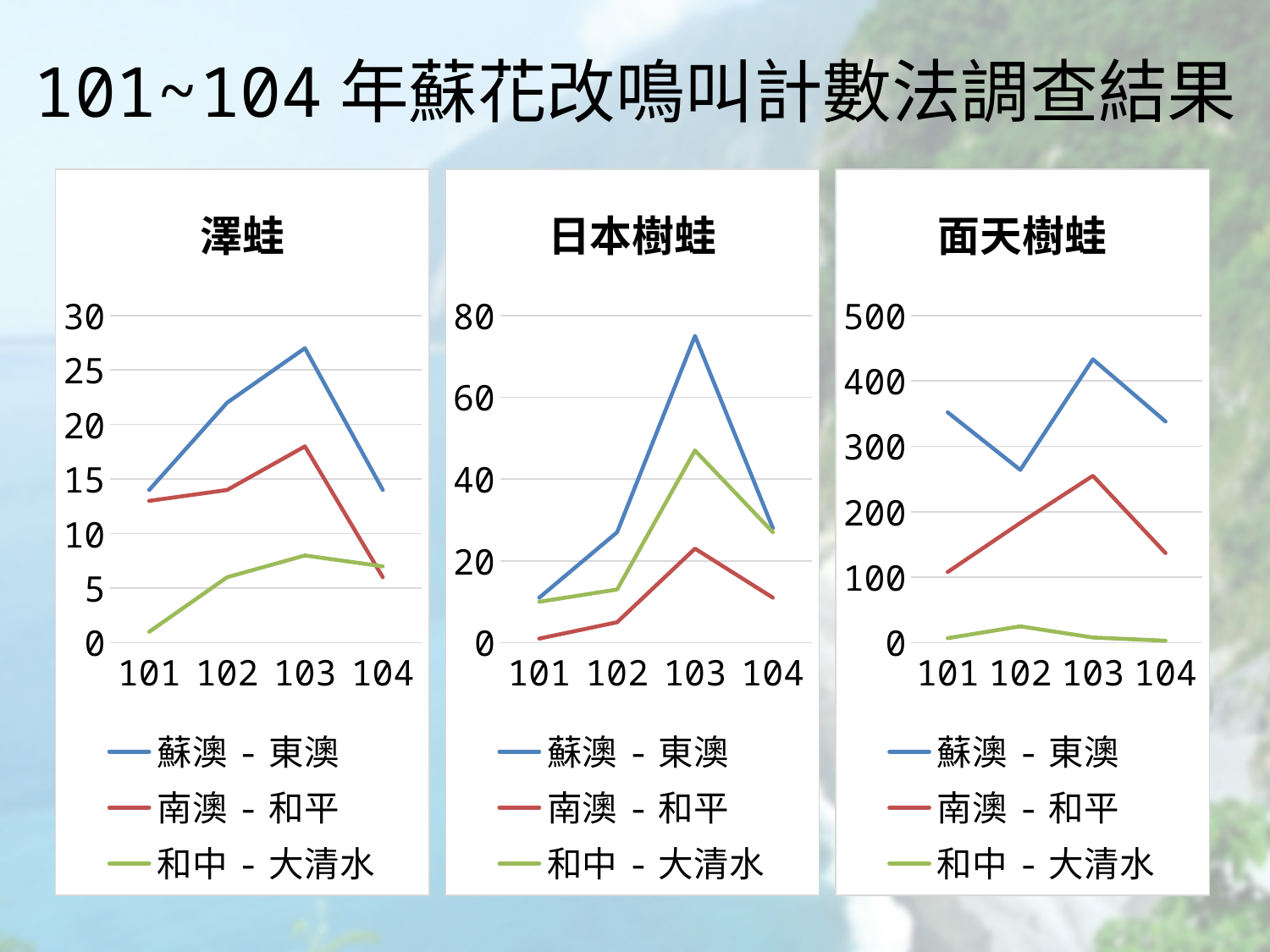
In the 面天樹蛙 chart, is the value for 蘇澳 - 東澳 in 103 greater or less than 400? greater In the 澤蛙 chart, does the 和中 - 大清水 line rise or fall from 101 to 103? rises In the 日本樹蛙 chart, which is larger in 103: 南澳 - 和平 or 和中 - 大清水? 和中 - 大清水 How many years are shown on the x axis of the 面天樹蛙 chart? 4 In the 日本樹蛙 chart, is the value for 蘇澳 - 東澳 in 103 greater or less than 60? greater What kind of chart is the 澤蛙 chart? line chart How many series does the legend of the 日本樹蛙 chart list? 3 In the 澤蛙 chart, in which year is the 蘇澳 - 東澳 line highest? 103 In the 面天樹蛙 chart, which series has the lowest values across all years? 和中 - 大清水 In the 日本樹蛙 chart, which series has the highest value in 103? 蘇澳 - 東澳 In the 澤蛙 chart, is the value for 蘇澳 - 東澳 in 103 greater or less than 25? greater